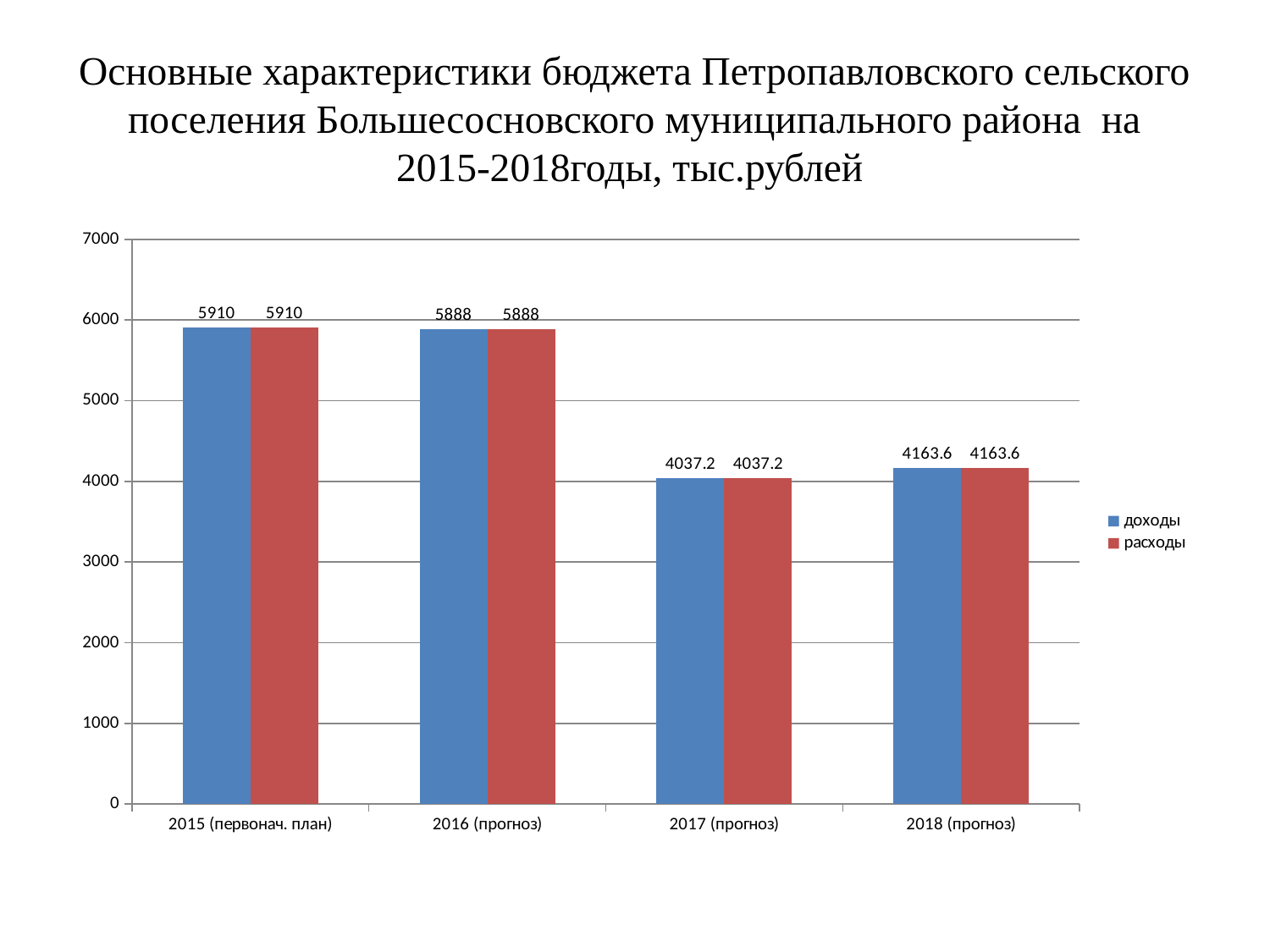
What is the difference between расходы in 2018 (прогноз) and расходы in 2017 (прогноз)? 126.4 What is the value of расходы for 2017 (прогноз)? 4037.2 What kind of chart is shown on the slide? bar chart What is the value of доходы for 2015 (первонач. план)? 5910 Is the value of расходы for 2017 (прогноз) greater or less than 5000? less What is the difference between доходы in 2015 (первонач. план) and доходы in 2016 (прогноз)? 22 Which category has the lowest value for расходы? 2017 (прогноз) How many series does the legend list? 2 How many categories are shown on the x axis? 4 Which category has the highest value for доходы? 2015 (первонач. план) Which is larger: доходы in 2016 (прогноз) or доходы in 2018 (прогноз)? 2016 (прогноз) What is the value of доходы for 2018 (прогноз)? 4163.6